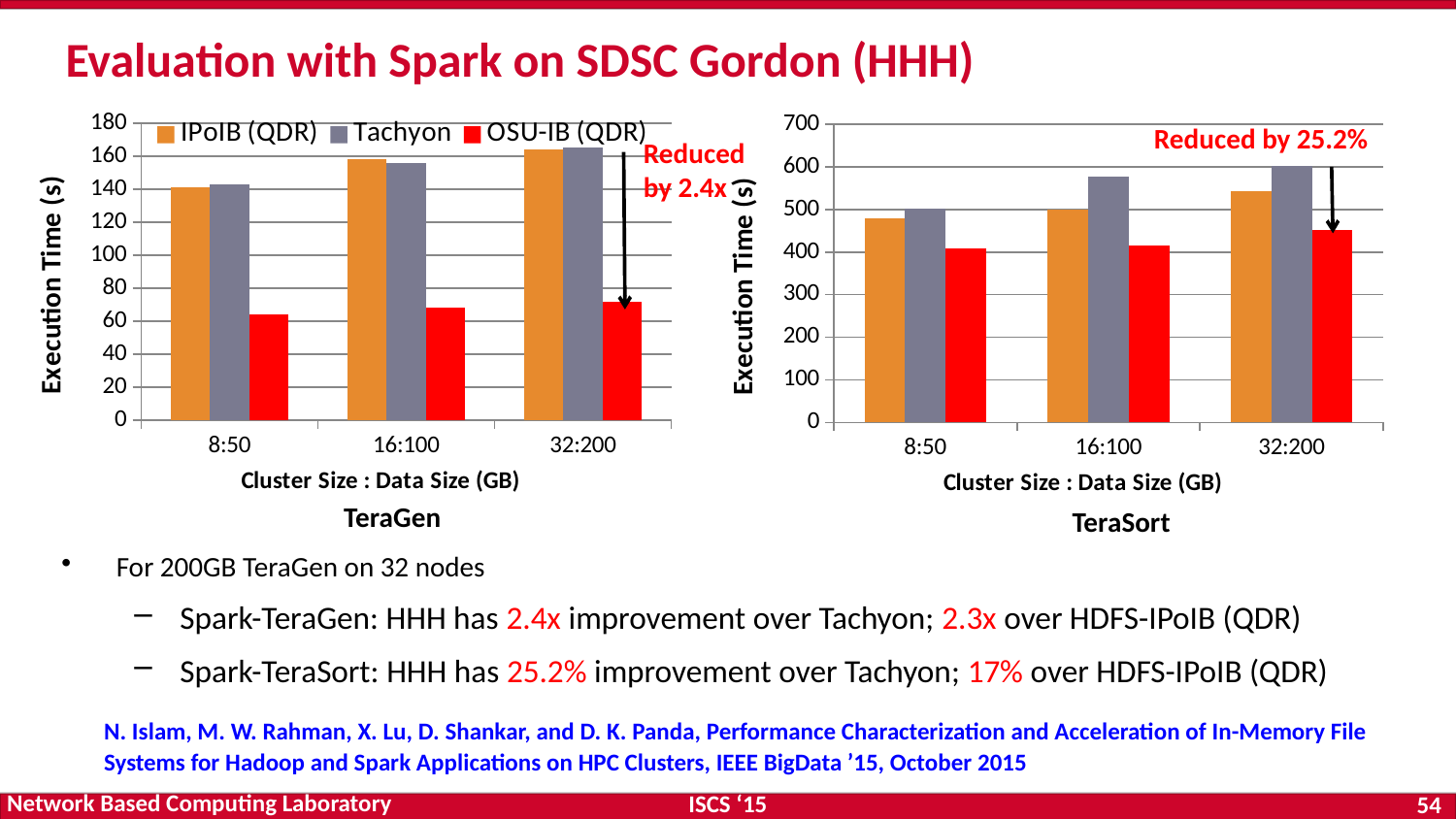
In the TeraSort chart, which is larger for 16:100: the IPoIB (QDR) bar or the Tachyon bar? Tachyon In the TeraGen chart, which series has the lowest execution time for 32:200? OSU-IB (QDR) In the TeraSort chart, which series has the highest execution time for 16:100? Tachyon In the TeraSort chart, is the Tachyon execution time for 16:100 greater or less than 500? greater What reduction is annotated on the TeraSort chart for 32:200? Reduced by 25.2% What kind of chart is the TeraGen chart on the left? bar chart How many cluster size : data size categories are shown on the x axis of the TeraSort chart? 3 In the TeraGen chart, is the OSU-IB (QDR) execution time for 8:50 greater or less than 80? less How many series does the legend of the TeraGen chart list? 3 In the TeraGen chart, does the OSU-IB (QDR) execution time rise or fall as the cluster size : data size increases from 8:50 to 32:200? rise In the TeraGen chart, is the Tachyon execution time for 32:200 greater or less than 160? greater